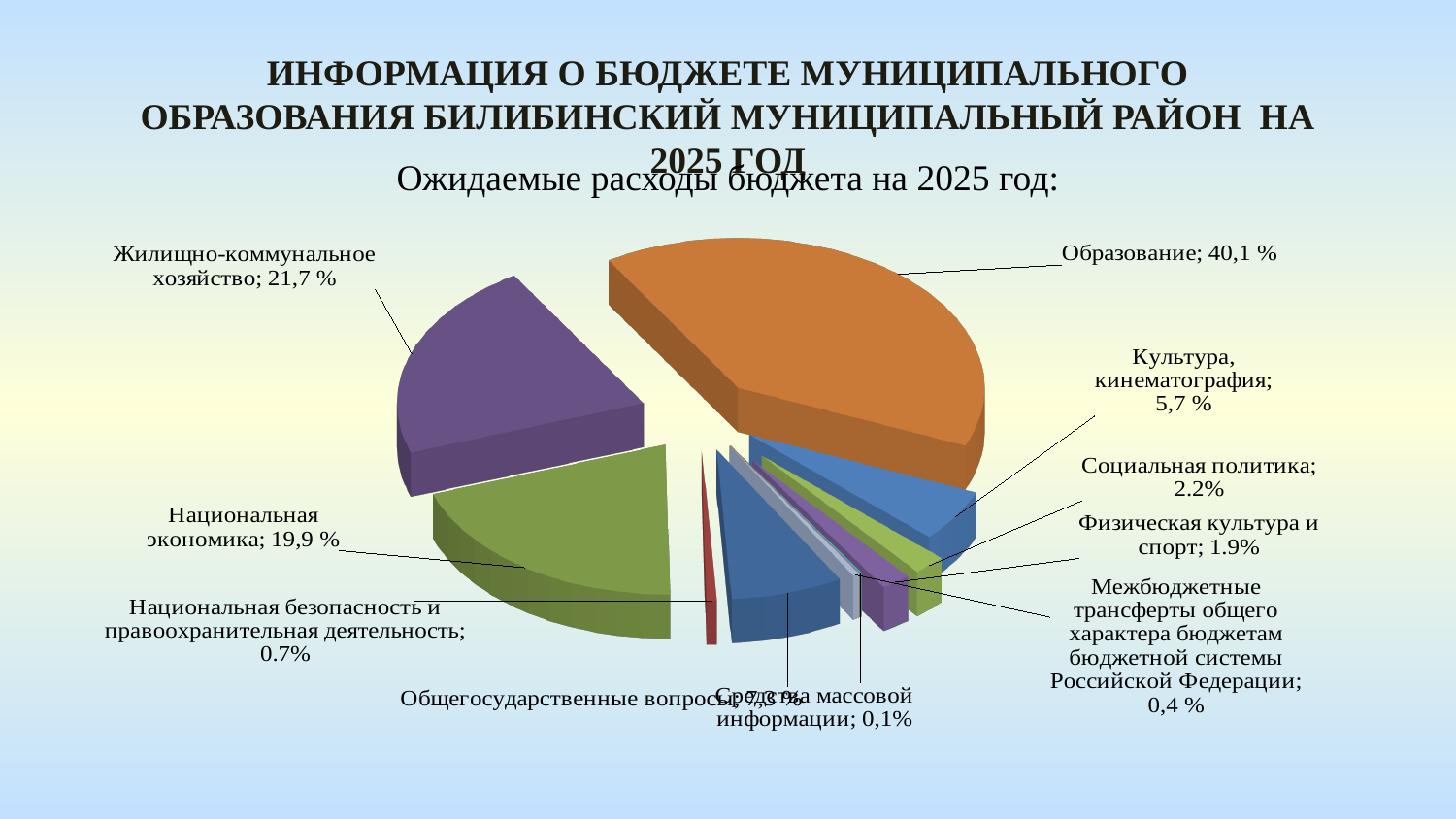
What share is shown for Культура, кинематография? 5,7 % What kind of chart is shown on the slide? pie chart What share is shown for Социальная политика? 2.2% What share is shown for Национальная экономика? 19,9 % What is the difference in percentage points between the shares for Образование and Жилищно-коммунальное хозяйство? 18,4 Which category has the smallest share of the pie? Средства массовой информации What share of the expected 2025 budget expenditures goes to Образование? 40,1 % Which is larger: the share for Физическая культура и спорт or the share for Социальная политика? Социальная политика What share is shown for Средства массовой информации? 0,1% How many categories (slices) does the pie chart show? 10 What share is shown for Жилищно-коммунальное хозяйство? 21,7 % Which category has the largest share of the pie? Образование